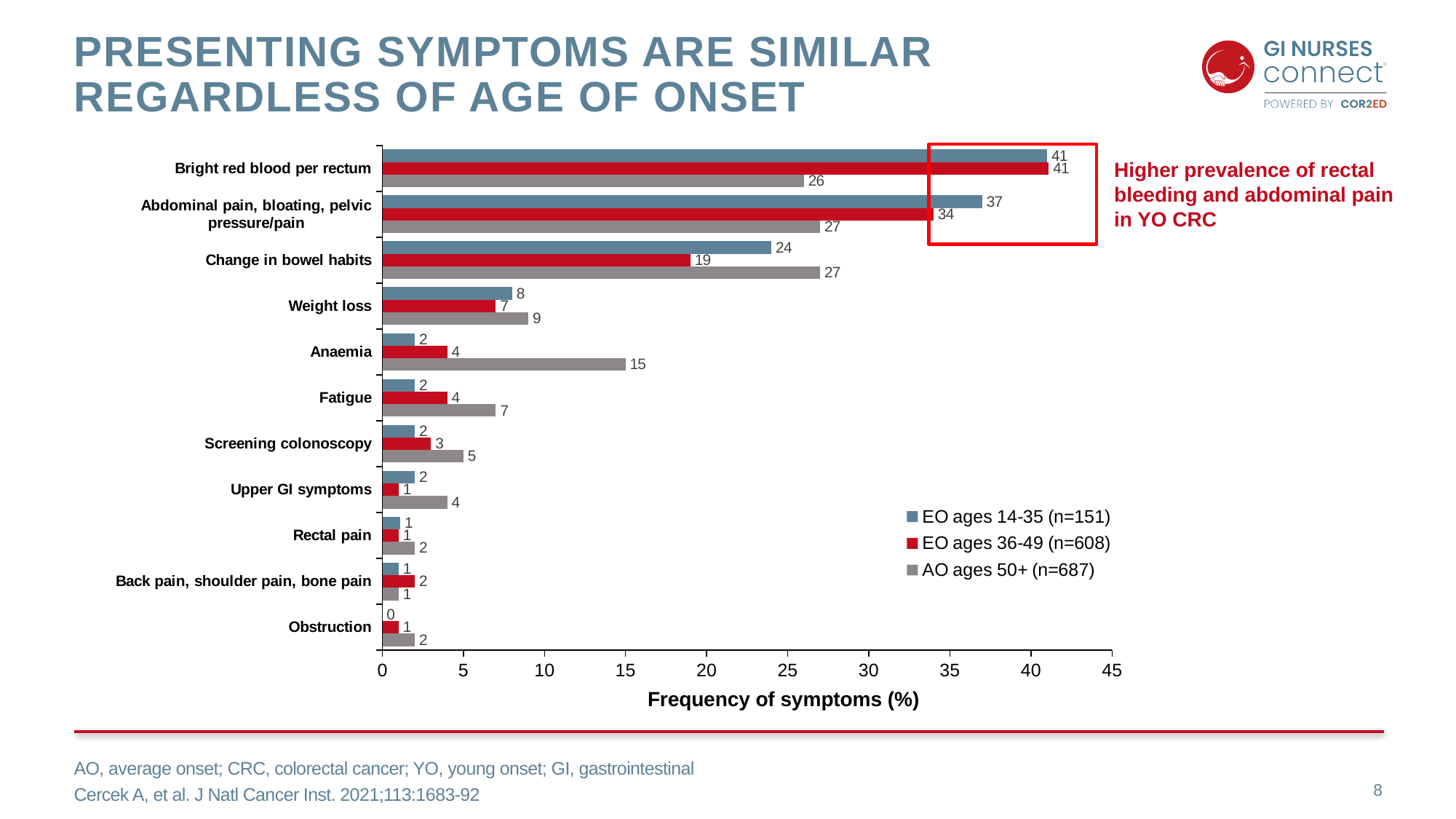
What is the value for Bright red blood per rectum in the AO ages 50+ (n=687) series? 26 What kind of chart is shown on the slide? Bar chart What is the label of the x axis? Frequency of symptoms (%) What is the value for Anaemia in the AO ages 50+ (n=687) series? 15 Which symptom has the highest value in the EO ages 14-35 (n=151) series? Bright red blood per rectum What is the value for Weight loss in the EO ages 36-49 (n=608) series? 7 For Change in bowel habits, which series has the larger value: EO ages 14-35 (n=151) or AO ages 50+ (n=687)? AO ages 50+ (n=687) What is the difference between the EO ages 14-35 and AO ages 50+ values for Abdominal pain, bloating, pelvic pressure/pain? 10 Which symptom has the lowest value in the EO ages 14-35 (n=151) series? Obstruction What is the value for Change in bowel habits in the EO ages 36-49 (n=608) series? 19 How many series does the legend list? 3 How many symptom categories are shown on the chart? 11